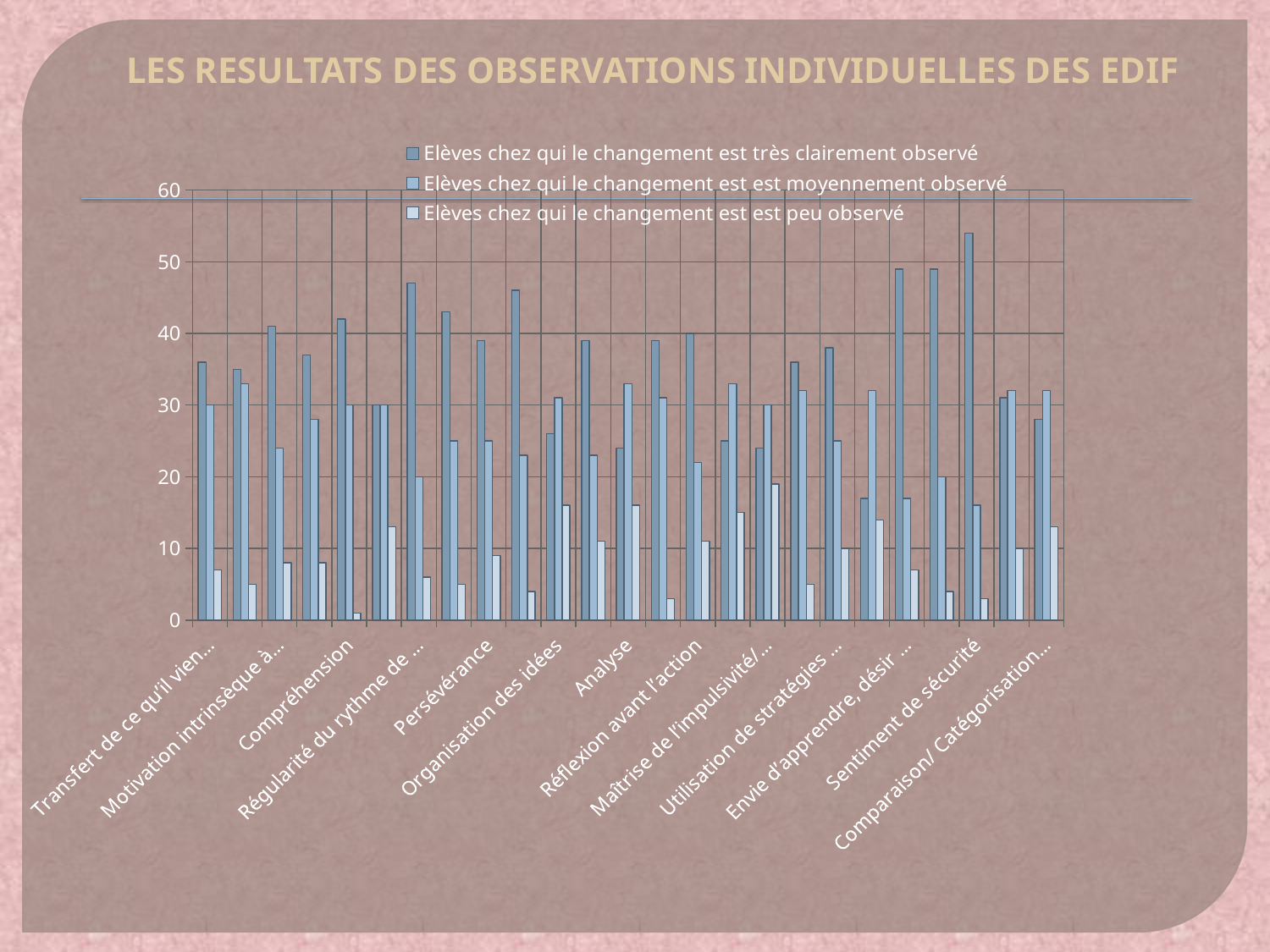
Is the value for 'Sentiment de sécurité' in the series 'Elèves chez qui le changement est très clairement observé' greater or less than 50? greater What is the title of the slide? LES RESULTATS DES OBSERVATIONS INDIVIDUELLES DES EDIF For 'Sentiment de sécurité', which series has the larger value: 'Elèves chez qui le changement est très clairement observé' or 'Elèves chez qui le changement est est peu observé'? Elèves chez qui le changement est très clairement observé Is the value for 'Analyse' in the series 'Elèves chez qui le changement est très clairement observé' greater or less than 30? less What kind of chart is shown on the slide? bar chart Is the value for 'Persévérance' in the series 'Elèves chez qui le changement est très clairement observé' greater or less than 30? greater How many series does the legend list? 3 What is the first legend entry of the chart? Elèves chez qui le changement est très clairement observé Which category has the highest value for 'Elèves chez qui le changement est très clairement observé'? Sentiment de sécurité For 'Analyse', which series has the larger value: 'Elèves chez qui le changement est très clairement observé' or 'Elèves chez qui le changement est est moyennement observé'? Elèves chez qui le changement est est moyennement observé